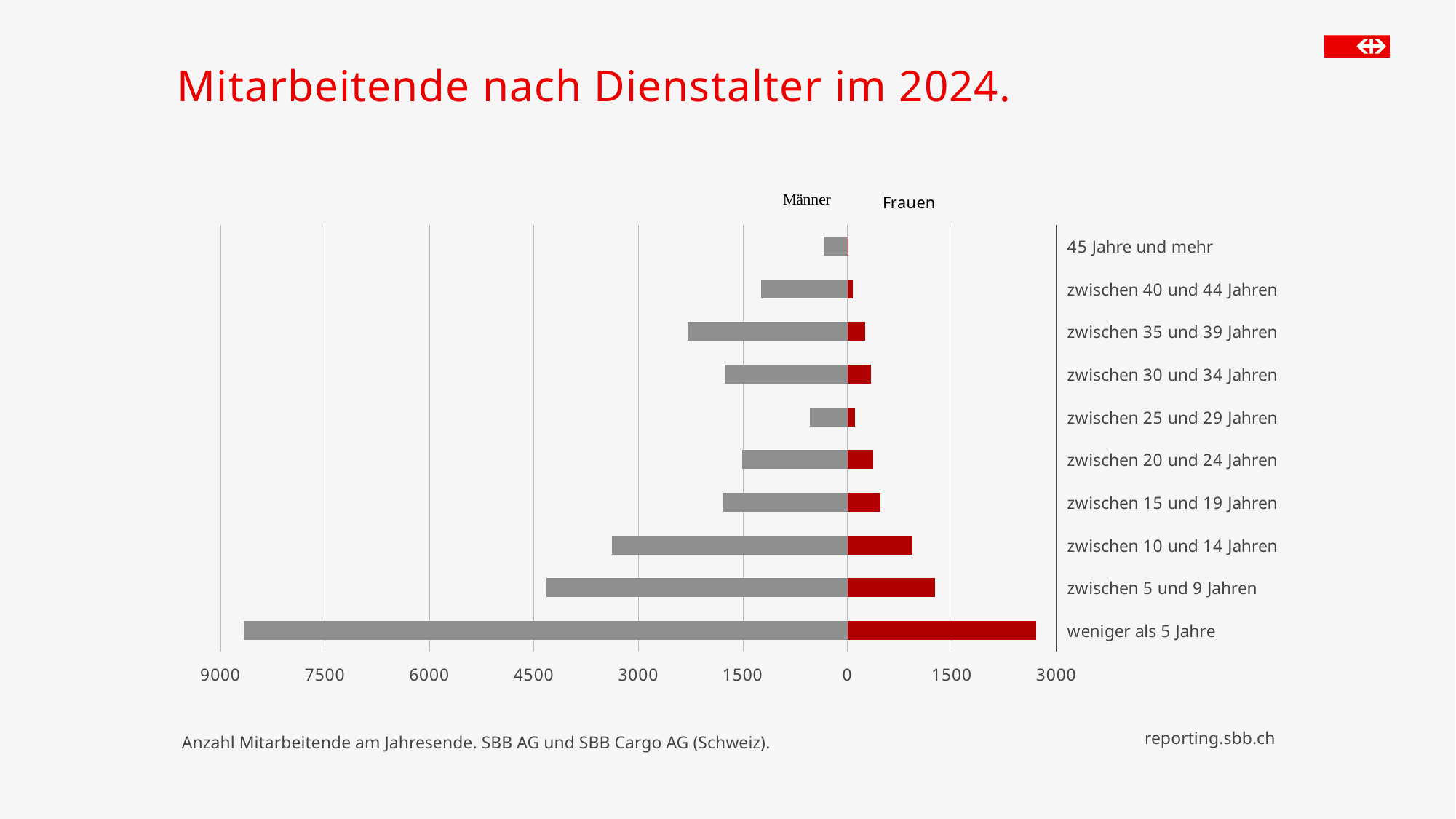
How many service-age categories are plotted in the chart? 10 Is the Frauen value for 'zwischen 5 und 9 Jahren' greater or less than 1500? less Which category has the lowest value for Männer? 45 Jahre und mehr How many series does the chart show? 2 What is the title of the chart? Mitarbeitende nach Dienstalter im 2024. For 'weniger als 5 Jahre', which is larger, the Männer value or the Frauen value? Männer Which category has the highest value for Frauen? weniger als 5 Jahre Which colour represents Frauen in the chart? red Is the Männer value for 'weniger als 5 Jahre' greater or less than 7500? greater What kind of chart is shown on the slide? bar chart Which category has the highest value for Männer? weniger als 5 Jahre Is the Männer value for 'zwischen 10 und 14 Jahren' greater or less than 3000? greater